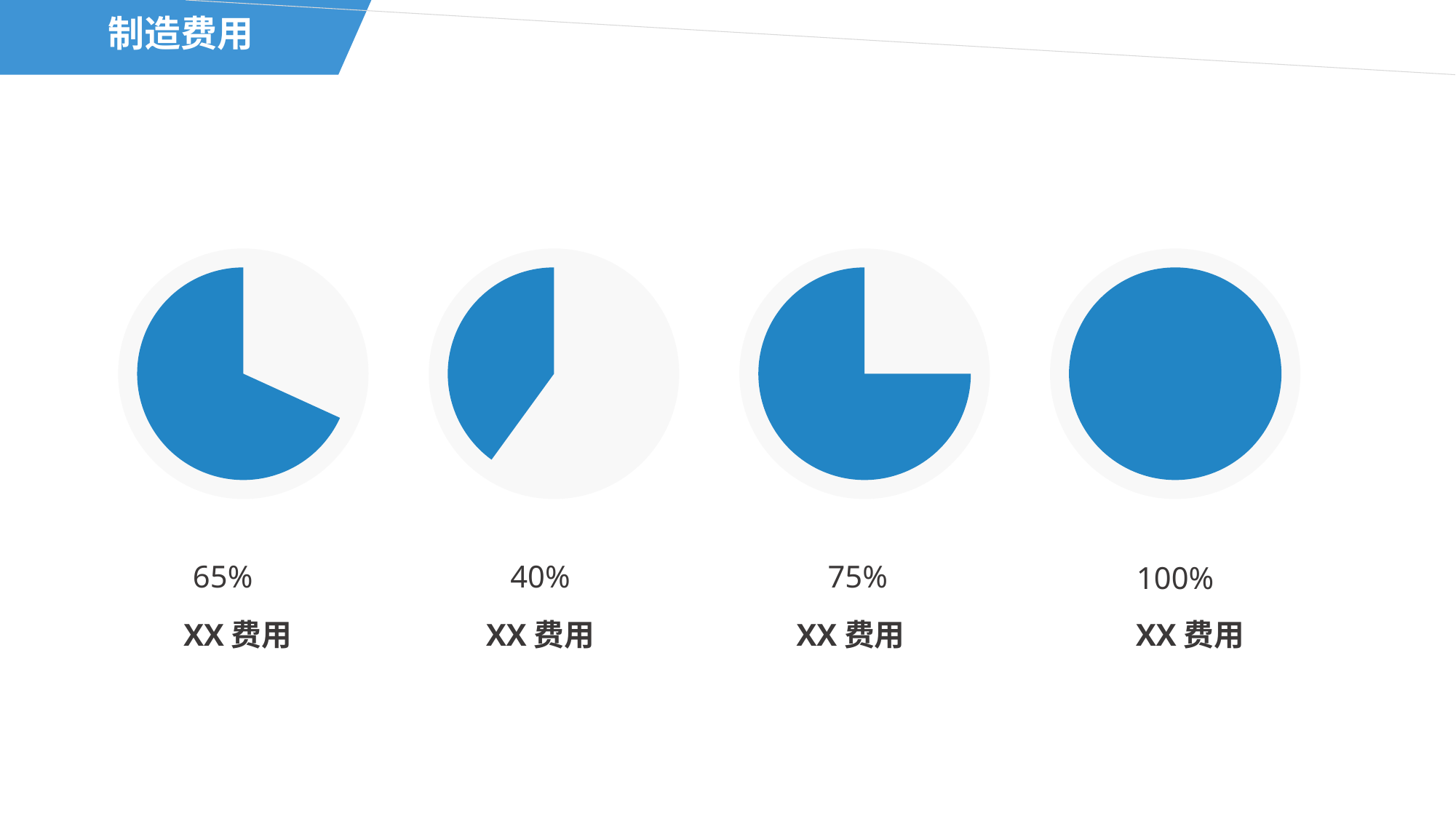
Which pie chart on the slide shows the highest percentage? The fourth (rightmost) chart, 100% What percentage is shown below the second pie chart from the left? 40% What is the difference between the percentage under the third pie chart and the percentage under the second pie chart? 35% How many pie charts are shown on the slide? 4 What percentage is shown below the fourth (rightmost) pie chart? 100% What kind of chart is used on this slide? Pie chart Which is larger: the percentage under the first pie chart or the percentage under the third pie chart? The third pie chart (75%) Which pie chart on the slide shows the lowest percentage? The second chart from the left, 40% What percentage is shown below the third pie chart from the left? 75% What is the title of the slide? 制造费用 What percentage is shown below the first (leftmost) pie chart? 65% What label appears in bold below each pie chart's percentage? XX 费用